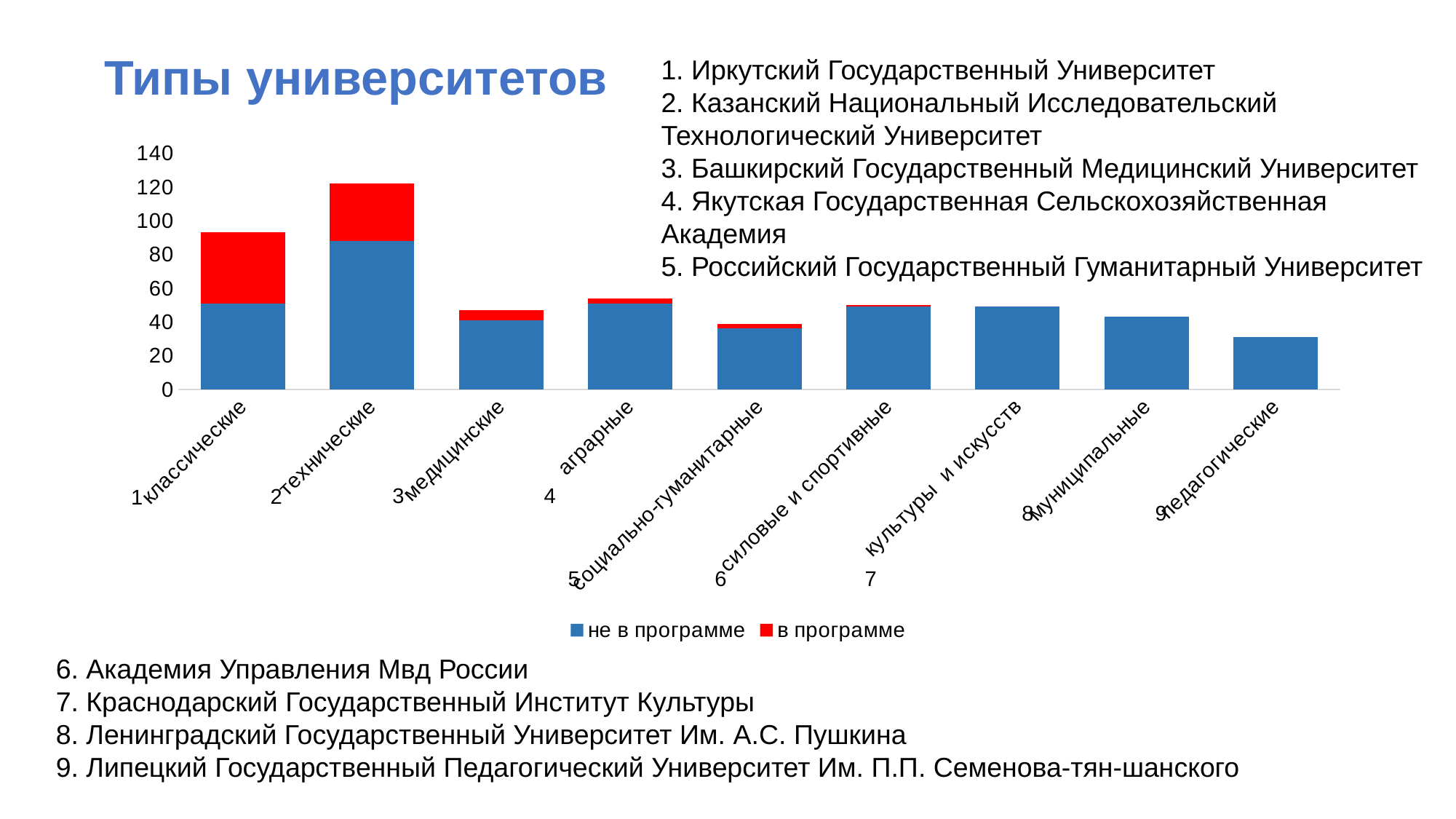
Which category has the lowest total bar in the chart? педагогические How many series does the chart legend list? 2 Which category has the highest total bar in the chart? технические Which has the larger total bar: классические or медицинские? классические What is the title of the slide containing the chart? Типы университетов Is the total value for классические greater or less than 80? greater Is the total value for медицинские greater or less than 60? less What kind of chart is shown on the slide? bar chart What are the two series named in the chart legend? не в программе, в программе Is the total value for педагогические greater or less than 40? less How many university types (categories) are shown on the x axis of the chart? 9